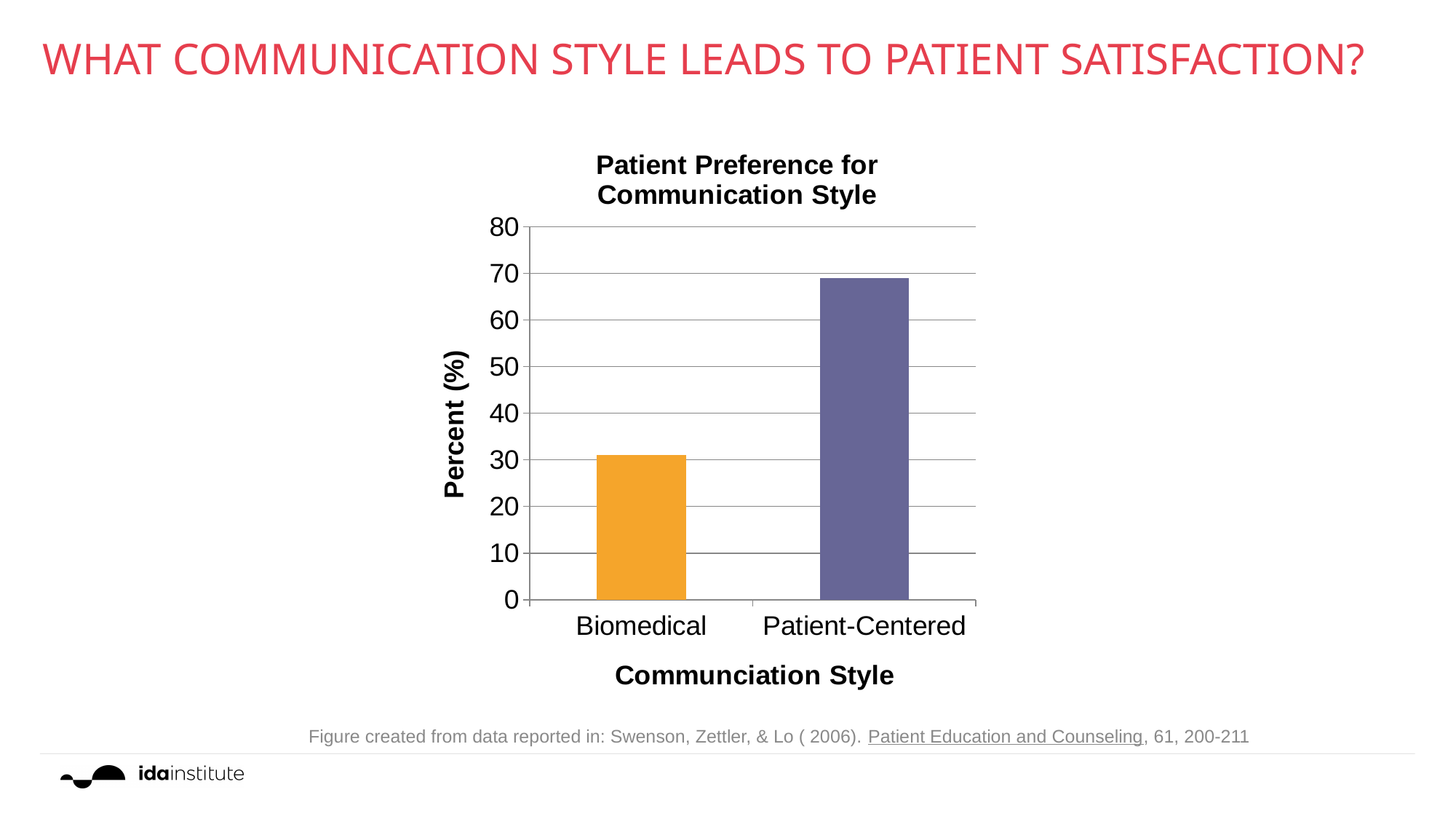
What kind of chart is shown on the slide? bar chart What is the title of the chart? Patient Preference for Communication Style Is the value for Biomedical greater or less than 40? less Is the value for Patient-Centered greater or less than 60? greater Which communication style has the highest patient preference in the chart? Patient-Centered What is the label of the y axis of the chart? Percent (%) Which is larger, the value for Biomedical or the value for Patient-Centered? Patient-Centered How many categories are plotted on the x axis of the chart? 2 Which communication style has the lowest patient preference in the chart? Biomedical Is the value for Biomedical greater or less than 20? greater